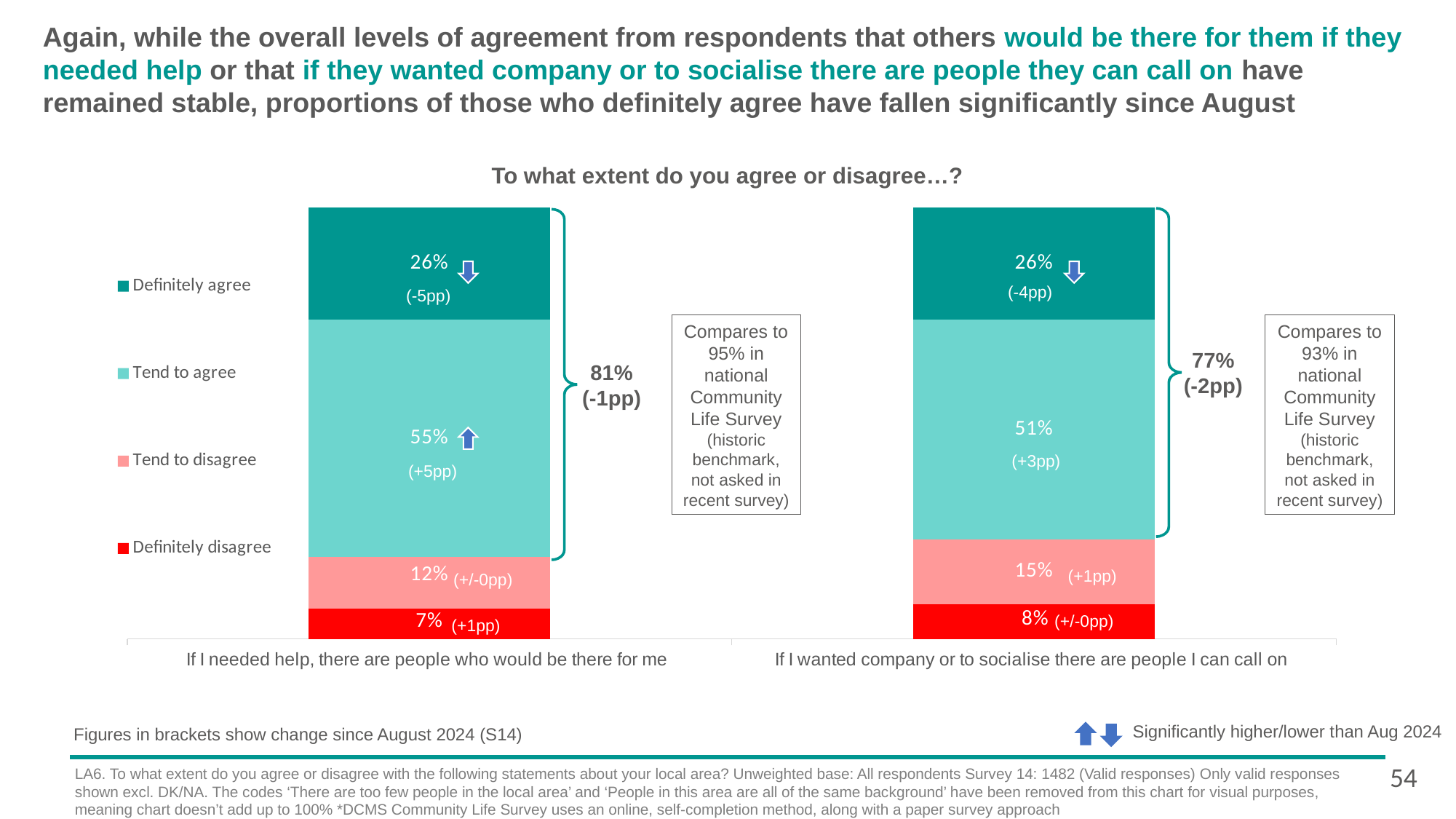
How many statements (categories) are shown on the x axis of the chart? 2 Which response category is the smallest for 'If I needed help, there are people who would be there for me'? Definitely disagree What percentage of respondents tend to agree that if they wanted company or to socialise there are people they can call on? 51% What percentage of respondents definitely disagree that if they needed help, there are people who would be there for them? 7% What is the combined agreement (definitely agree plus tend to agree) shown for 'If I needed help, there are people who would be there for me'? 81% What is the difference between the 'Tend to agree' percentages for the two statements? 4 percentage points What kind of chart is shown on the slide? Stacked bar chart Which statement has the higher 'Tend to disagree' percentage? If I wanted company or to socialise there are people I can call on Which response category is the largest for 'If I wanted company or to socialise there are people I can call on'? Tend to agree What percentage of respondents definitely agree that if they needed help, there are people who would be there for them? 26% How many series does the legend list? 4 What percentage of respondents tend to disagree that if they wanted company or to socialise there are people they can call on? 15%